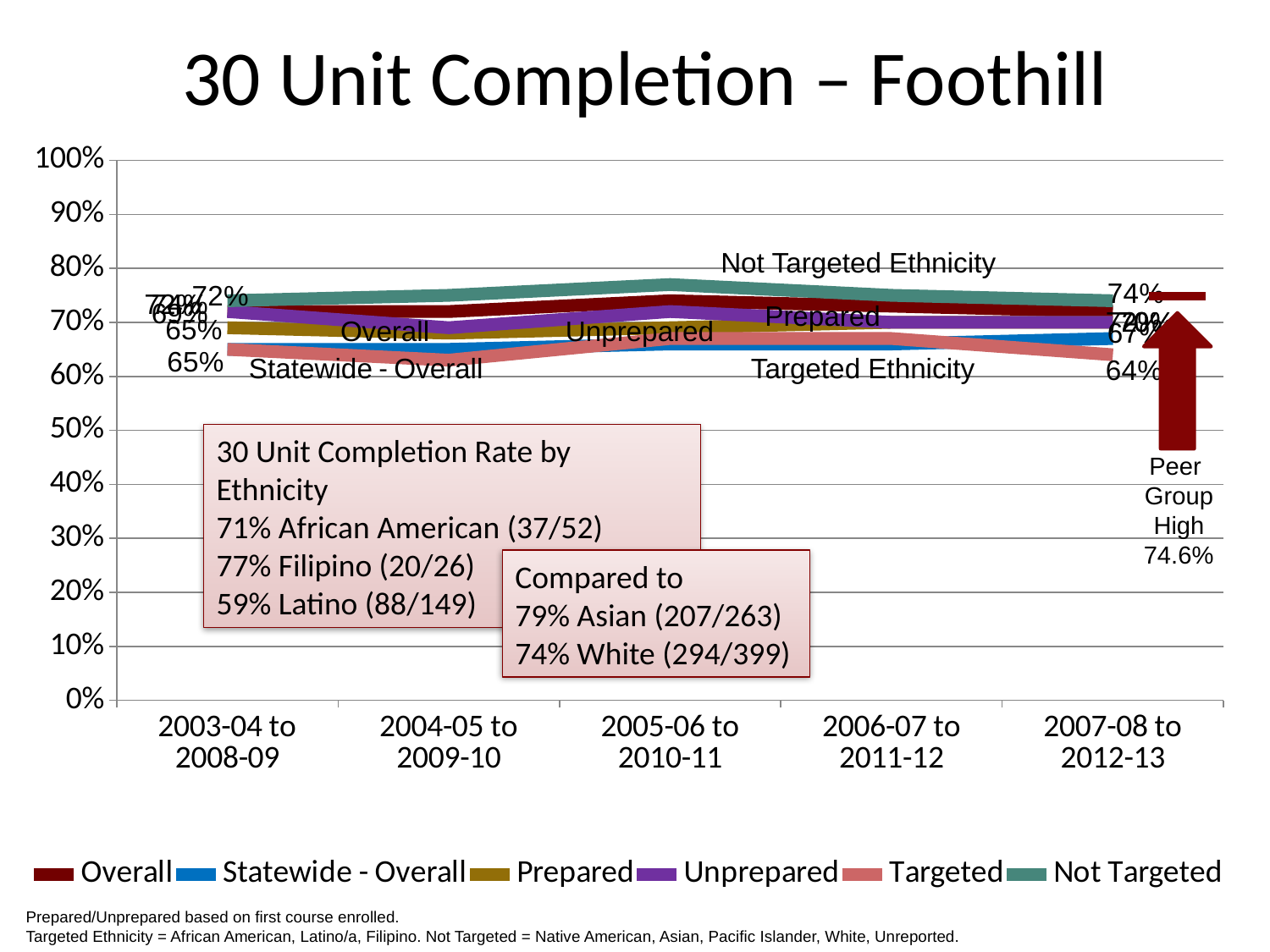
Which series has the lowest value in 2007-08 to 2012-13? Targeted In 2007-08 to 2012-13, which is larger: Not Targeted or Targeted? Not Targeted Is the value for Statewide - Overall in 2004-05 to 2009-10 greater or less than 70%? less What is the difference between Not Targeted (74%) and Targeted (64%) in 2007-08 to 2012-13? 10 percentage points What is the value for Targeted in 2007-08 to 2012-13? 64% How many time periods are shown along the x axis? 5 What is the value for Not Targeted in 2007-08 to 2012-13? 74% How many series does the legend list? 6 Is the value for Overall in 2005-06 to 2010-11 greater or less than 70%? greater What kind of chart is shown on the slide? line chart Which series has the highest value in 2007-08 to 2012-13? Not Targeted What is the title of the chart? 30 Unit Completion – Foothill